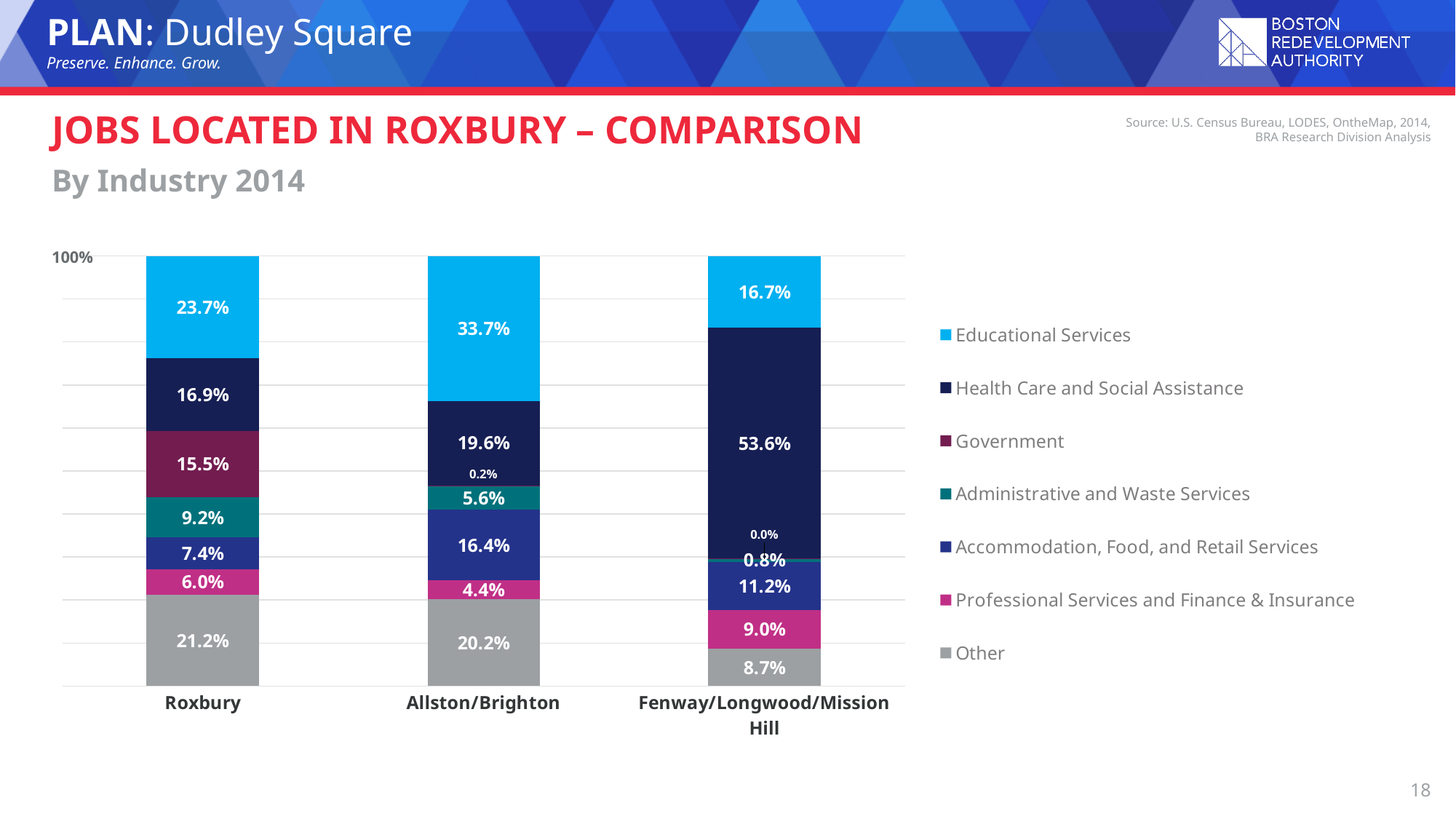
What share of jobs in Roxbury are in Educational Services? 23.7% Which neighborhood has the highest share of jobs in Educational Services? Allston/Brighton What is the difference between the Health Care and Social Assistance share in Fenway/Longwood/Mission Hill and in Roxbury? 36.7 percentage points Which neighborhood has the lowest share of jobs in the Other category? Fenway/Longwood/Mission Hill Which is larger: the Professional Services and Finance & Insurance share in Roxbury or in Allston/Brighton? Roxbury How many industry categories does the legend list? 7 What share of jobs in Fenway/Longwood/Mission Hill are in Health Care and Social Assistance? 53.6% Which industry is shown in light blue at the top of each bar? Educational Services What type of chart is shown on the slide? Stacked bar chart What share of jobs in Roxbury are in Government? 15.5% How many neighborhoods are compared in the chart? 3 What share of jobs in Allston/Brighton are in Accommodation, Food, and Retail Services? 16.4%